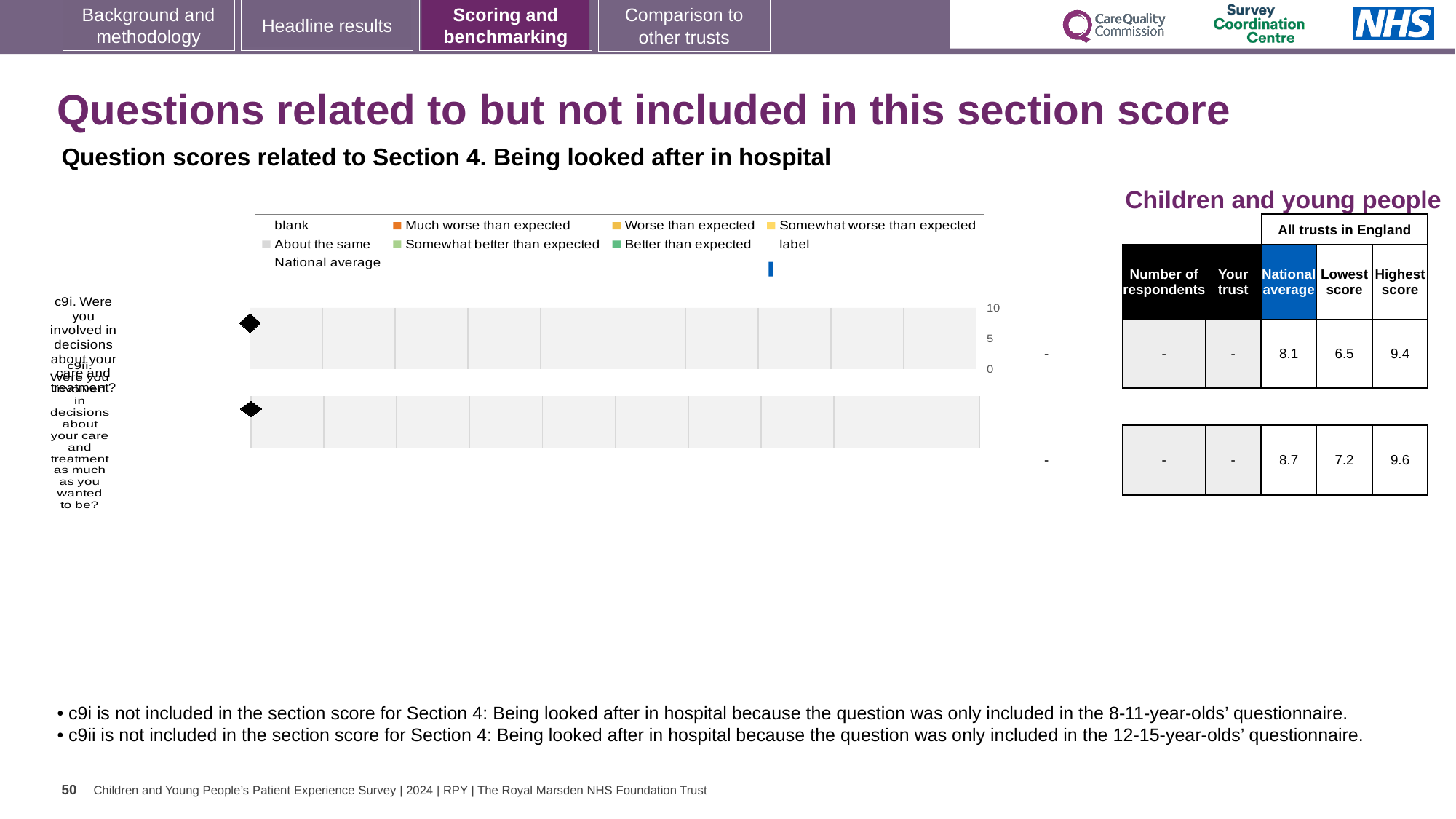
In the table, what is the lowest score across all trusts in England for c9i? 6.5 In the table, what is the difference between the highest and lowest scores for c9ii? 2.4 What is the highest value shown on the chart's axis? 10 In the table, what is the difference between the highest and lowest scores for c9i? 2.9 What kind of chart is shown on the slide? bar chart In the table, what is the highest score across all trusts in England for c9ii? 9.6 Which legend entry is shown with a dark blue marker? National average How many questions (categories) are plotted in the chart? 2 In the table, what is the national average score for c9ii (Were you involved in decisions about your care and treatment as much as you wanted to be?)? 8.7 In the table, what is the national average score for c9i (Were you involved in decisions about your care and treatment?)? 8.1 In the table, which question has the higher national average, c9i or c9ii? c9ii In the table, what value is shown for 'Your trust' for c9i? -